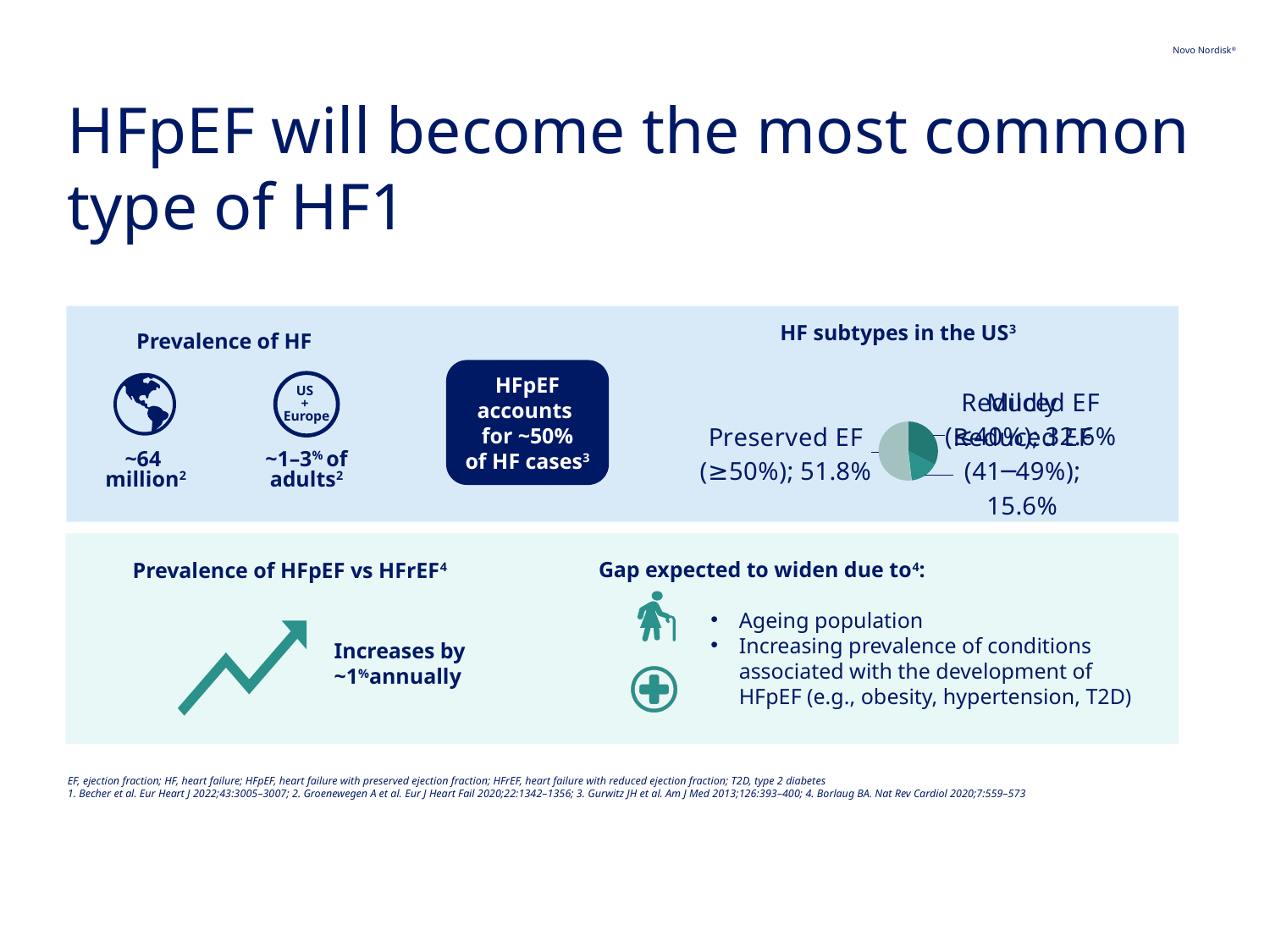
In the 'HF subtypes in the US' pie chart, what percentage is shown for Mildly reduced EF (41–49%)? 15.6% What is the title of the pie chart on the slide? HF subtypes in the US In the 'HF subtypes in the US' pie chart, what percentage is shown for Preserved EF (≥50%)? 51.8% In the 'HF subtypes in the US' pie chart, which HF subtype has the smallest share? Mildly reduced EF (41–49%) In the 'HF subtypes in the US' pie chart, which is larger: the share for Preserved EF or the share for Mildly reduced EF? Preserved EF What kind of chart is shown under the heading 'HF subtypes in the US'? Pie chart How many slices does the 'HF subtypes in the US' pie chart have? 3 In the 'HF subtypes in the US' pie chart, which HF subtype has the largest share? Preserved EF (≥50%) In the 'HF subtypes in the US' pie chart, how many percentage points larger is the Preserved EF share than the Mildly reduced EF share? 36.2 percentage points